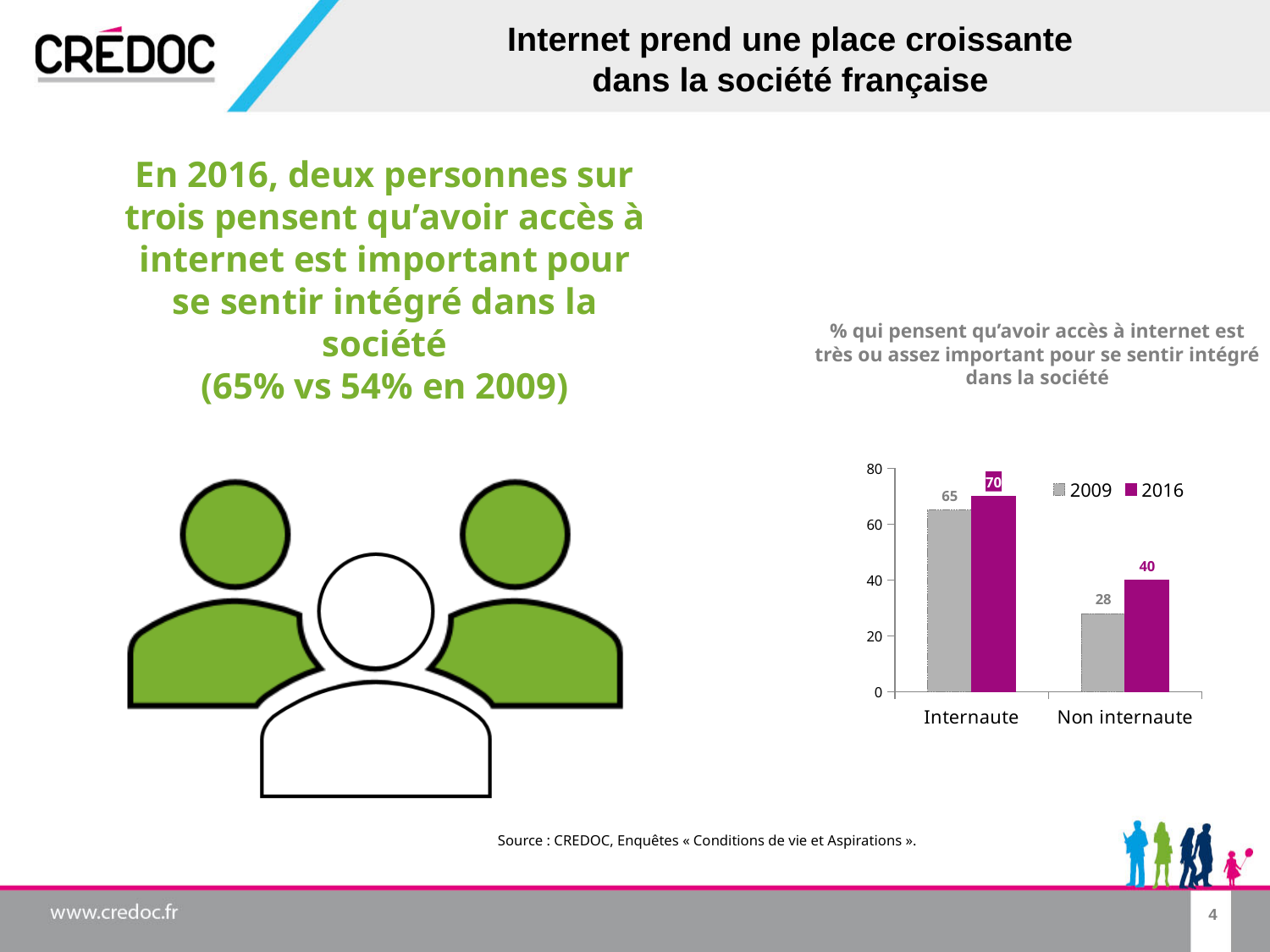
What is the value for Non internaute in 2009? 28 What is the difference between the Internaute and Non internaute values in 2016? 30 Which is larger: the 2009 value for Internaute or the 2016 value for Non internaute? 2009 value for Internaute Which category has the highest value in 2016? Internaute Which category has the lowest value in 2009? Non internaute What is the difference between the 2016 and 2009 values for Non internaute? 12 What is the value for Non internaute in 2016? 40 How many series does the chart legend list? 2 What is the value for Internaute in 2016? 70 What is the value for Internaute in 2009? 65 What kind of chart is shown on the slide? Bar chart How many categories are shown on the x axis of the chart? 2